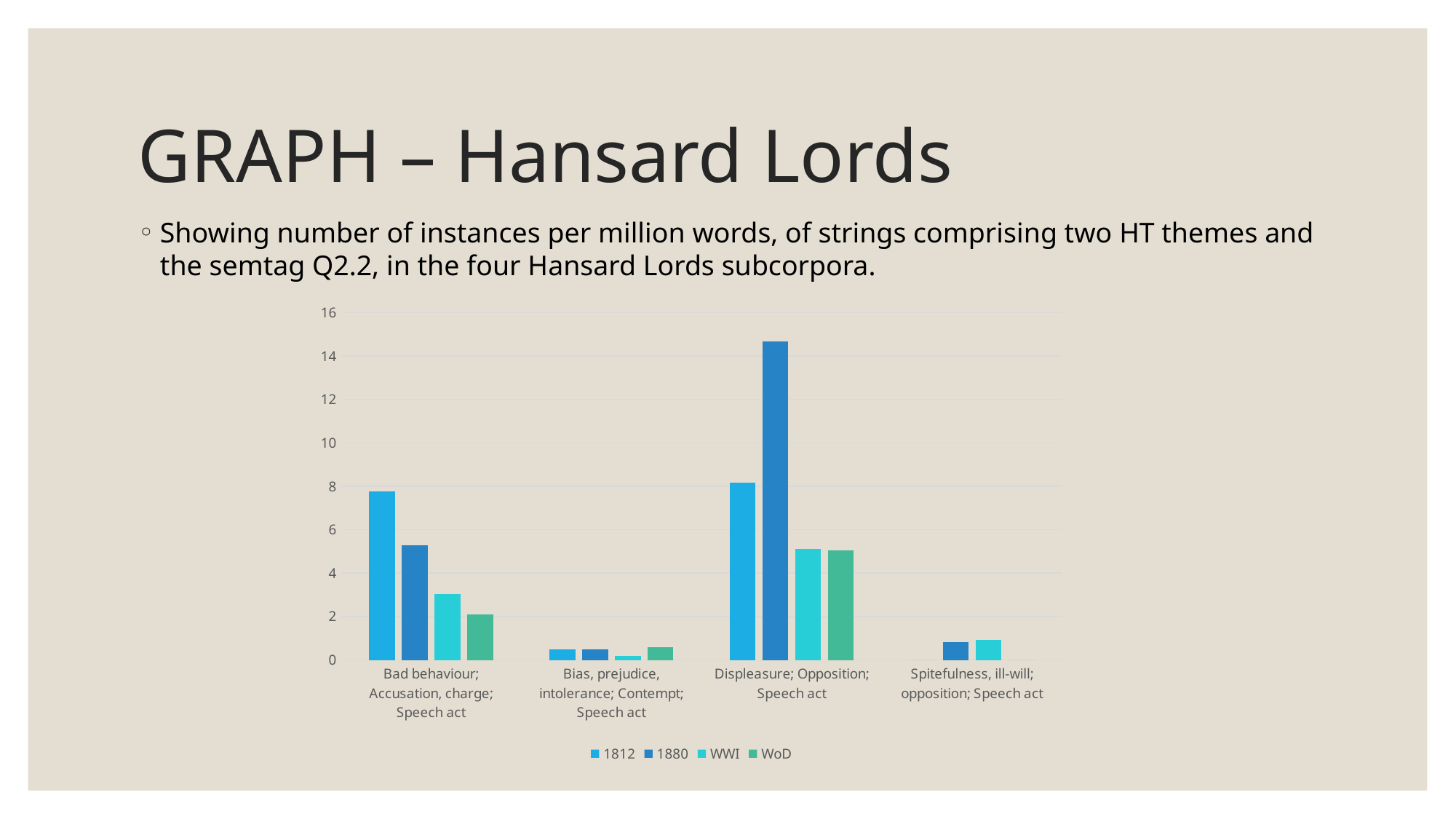
Is the WWI value for Displeasure; Opposition; Speech act greater or less than 4? greater How many series does the legend list? 4 What are the entries listed in the chart's legend? 1812, 1880, WWI, WoD Which category has the highest bar for the 1880 series? Displeasure; Opposition; Speech act For Displeasure; Opposition; Speech act, which is larger: the 1812 value or the 1880 value? 1880 Is the 1812 value for Bad behaviour; Accusation, charge; Speech act greater or less than 6? greater Is the 1880 value for Displeasure; Opposition; Speech act greater or less than 14? greater What kind of chart is shown on the slide? Bar chart Which series has the lowest bar for Bad behaviour; Accusation, charge; Speech act? WoD For Bad behaviour; Accusation, charge; Speech act, which is larger: the 1812 value or the 1880 value? 1812 How many categories are shown on the x axis? 4